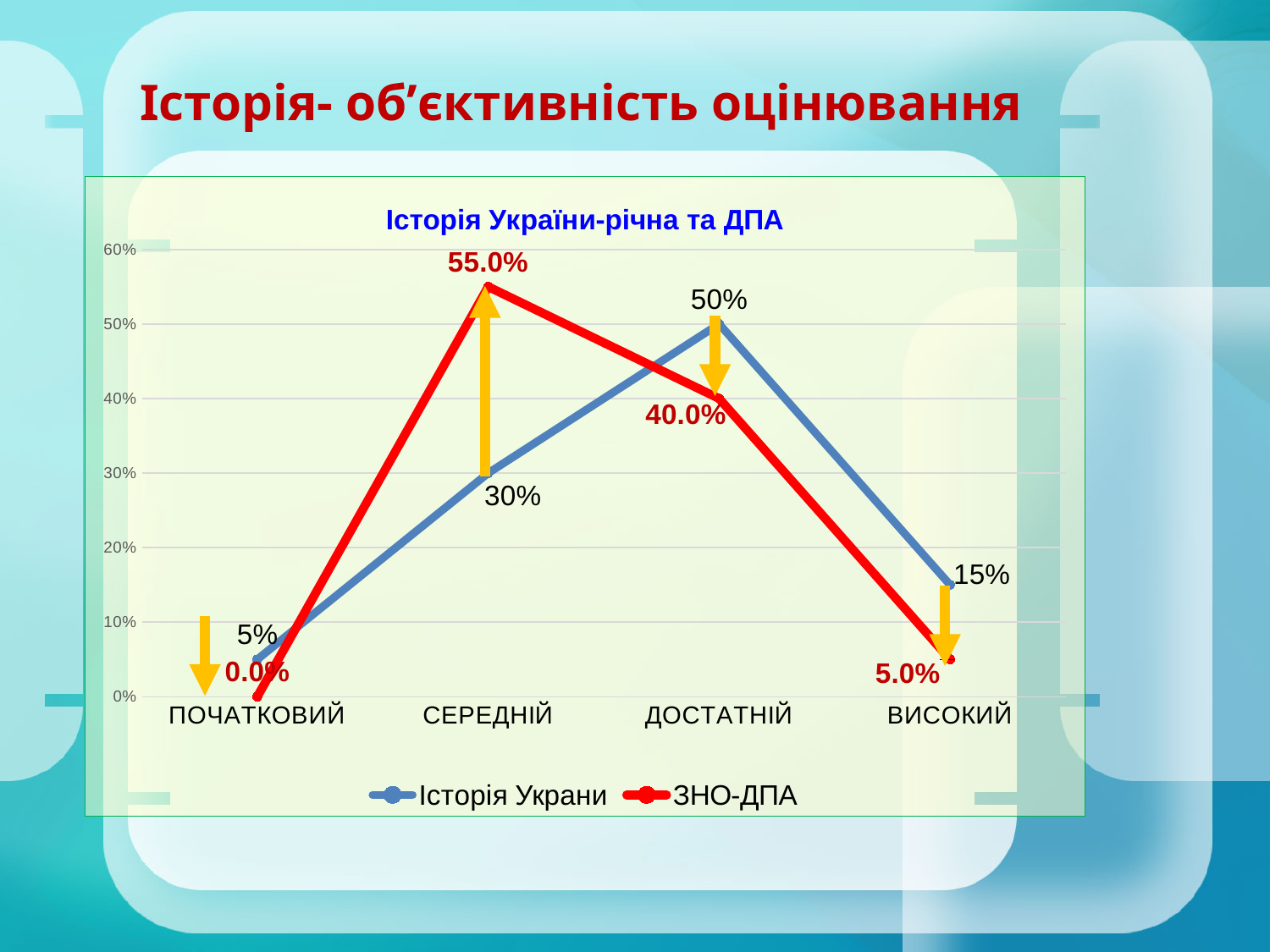
What is the value of the ЗНО-ДПА series for СЕРЕДНІЙ? 55.0% What is the value of the ЗНО-ДПА series for ВИСОКИЙ? 5.0% Which category has the lowest value in the ЗНО-ДПА series? ПОЧАТКОВИЙ How many series does the legend list? 2 Which category has the highest value in the Історія Украни series? ДОСТАТНІЙ What is the value of the Історія Украни series for ДОСТАТНІЙ? 50% What is the title of the chart? Історія України-річна та ДПА What type of chart is shown on the slide? line chart Which colour is used for the ЗНО-ДПА series line? red How many categories are shown on the x axis? 4 For ДОСТАТНІЙ, which series has the larger value, Історія Украни or ЗНО-ДПА? Історія Украни What is the difference between the ЗНО-ДПА and Історія Украни values for СЕРЕДНІЙ? 25%